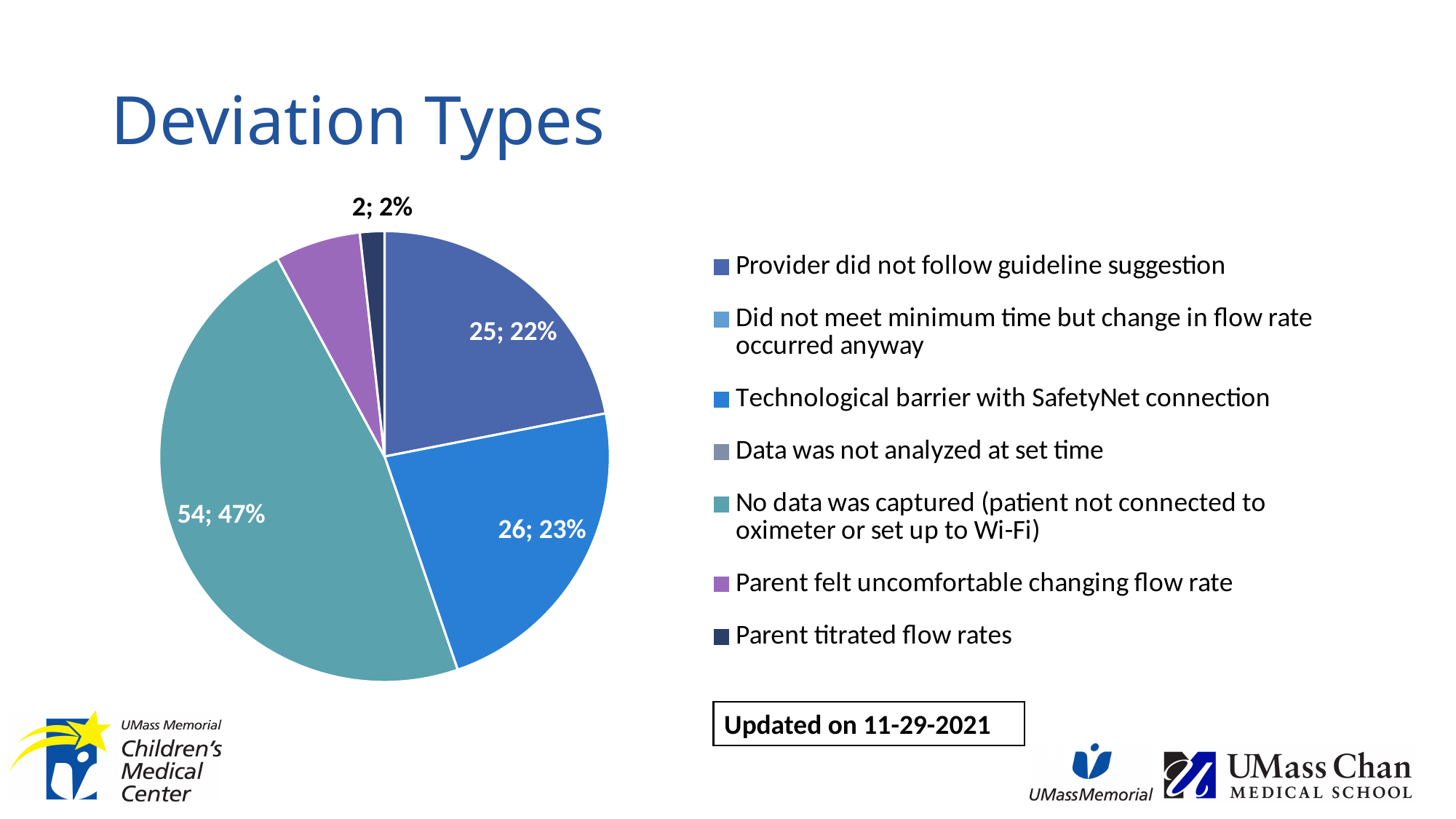
What kind of chart is shown on the slide? Pie chart How many deviations fall under "No data was captured (patient not connected to oximeter or set up to Wi-Fi)"? 54 Which deviation type accounts for the smallest visible slice of the pie? Parent titrated flow rates Which deviation type accounts for the largest slice of the pie? No data was captured (patient not connected to oximeter or set up to Wi-Fi) How many more deviations are in "No data was captured" than in "Technological barrier with SafetyNet connection"? 28 What percentage of deviations are "Technological barrier with SafetyNet connection"? 23% How many deviations are attributed to "Provider did not follow guideline suggestion"? 25 How many deviation types are listed in the legend? 7 What is the difference in count between "Technological barrier with SafetyNet connection" and "Provider did not follow guideline suggestion"? 1 What is the title of the slide containing the chart? Deviation Types Which has more deviations: "Technological barrier with SafetyNet connection" or "Provider did not follow guideline suggestion"? Technological barrier with SafetyNet connection What share of the pie is "Parent titrated flow rates"? 2%